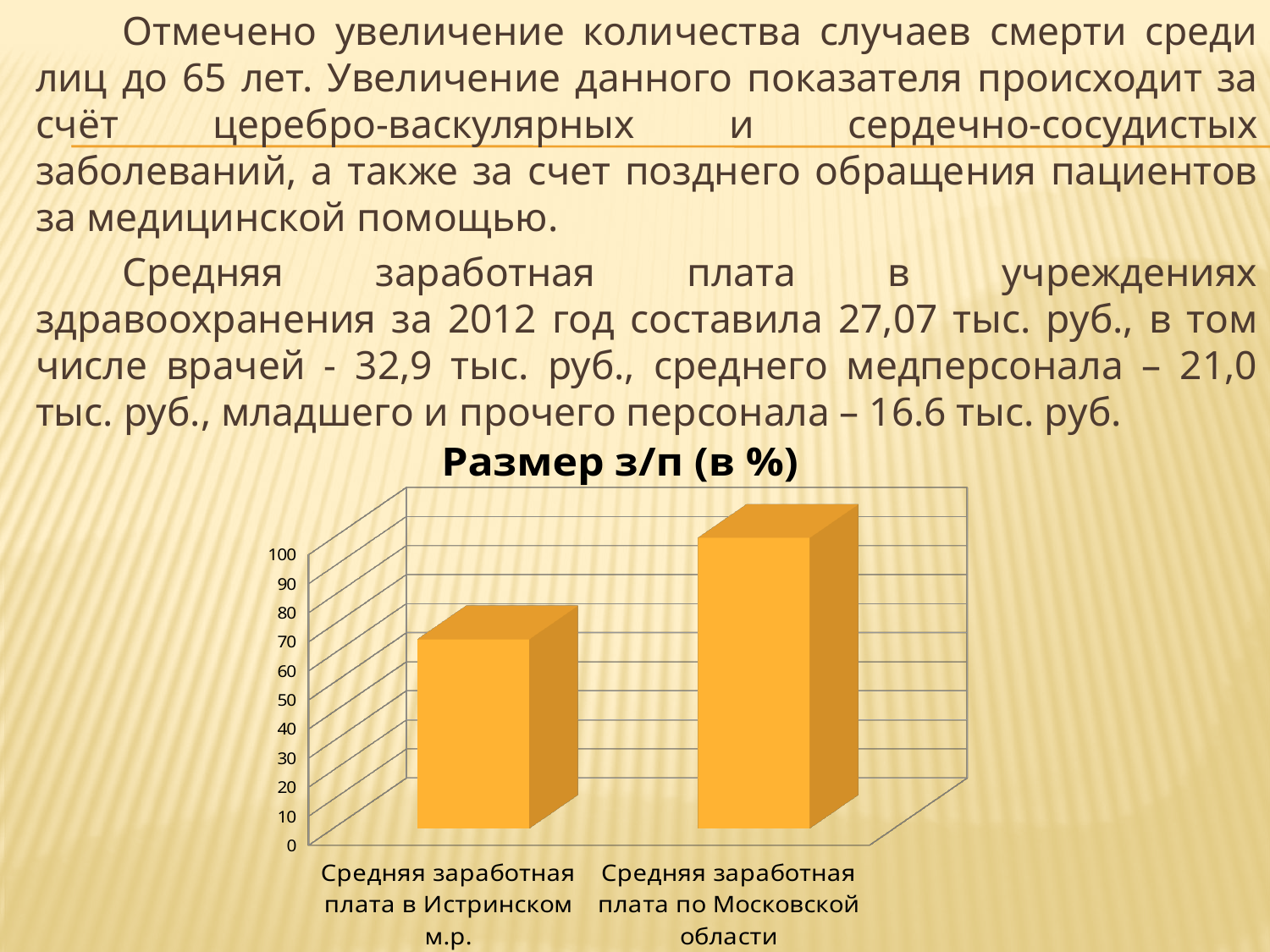
Which category has the lowest value in the chart? Средняя заработная плата в Истринском м.р. How many categories (bars) does the chart show? 2 What is the maximum value shown on the vertical axis of the chart? 100 Is the value for Средняя заработная плата в Истринском м.р. greater or less than 50? greater Is the value for Средняя заработная плата по Московской области greater or less than 80? greater Which is larger: the value for Средняя заработная плата в Истринском м.р. or the value for Средняя заработная плата по Московской области? Средняя заработная плата по Московской области Which category has the highest value in the chart? Средняя заработная плата по Московской области Is the value for Средняя заработная плата в Истринском м.р. greater or less than 90? less What kind of chart is shown on the slide? bar chart What is the title of the chart? Размер з/п (в %)